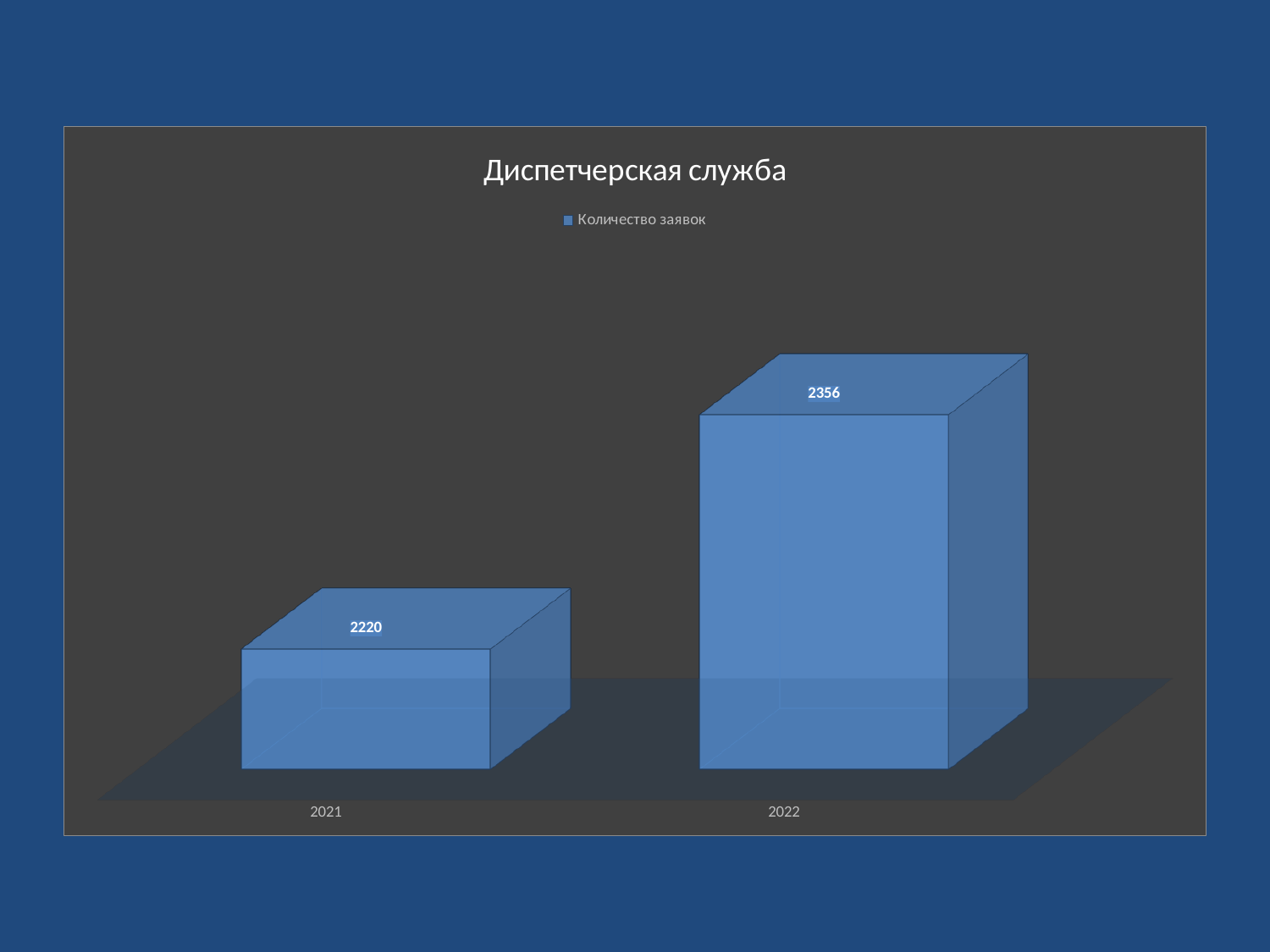
What is the value for 2022? 2356 Which year has the lowest value? 2021 What kind of chart is shown? bar chart What is the title of the chart? Диспетчерская служба What is the value for 2021? 2220 How many categories are shown on the x axis? 2 Which is larger, the value for 2021 or the value for 2022? 2022 What series name is shown in the legend? Количество заявок Do the values rise or fall from 2021 to 2022? rise How many series does the legend list? 1 Which year has the highest value? 2022 What is the difference between the values for 2022 and 2021? 136